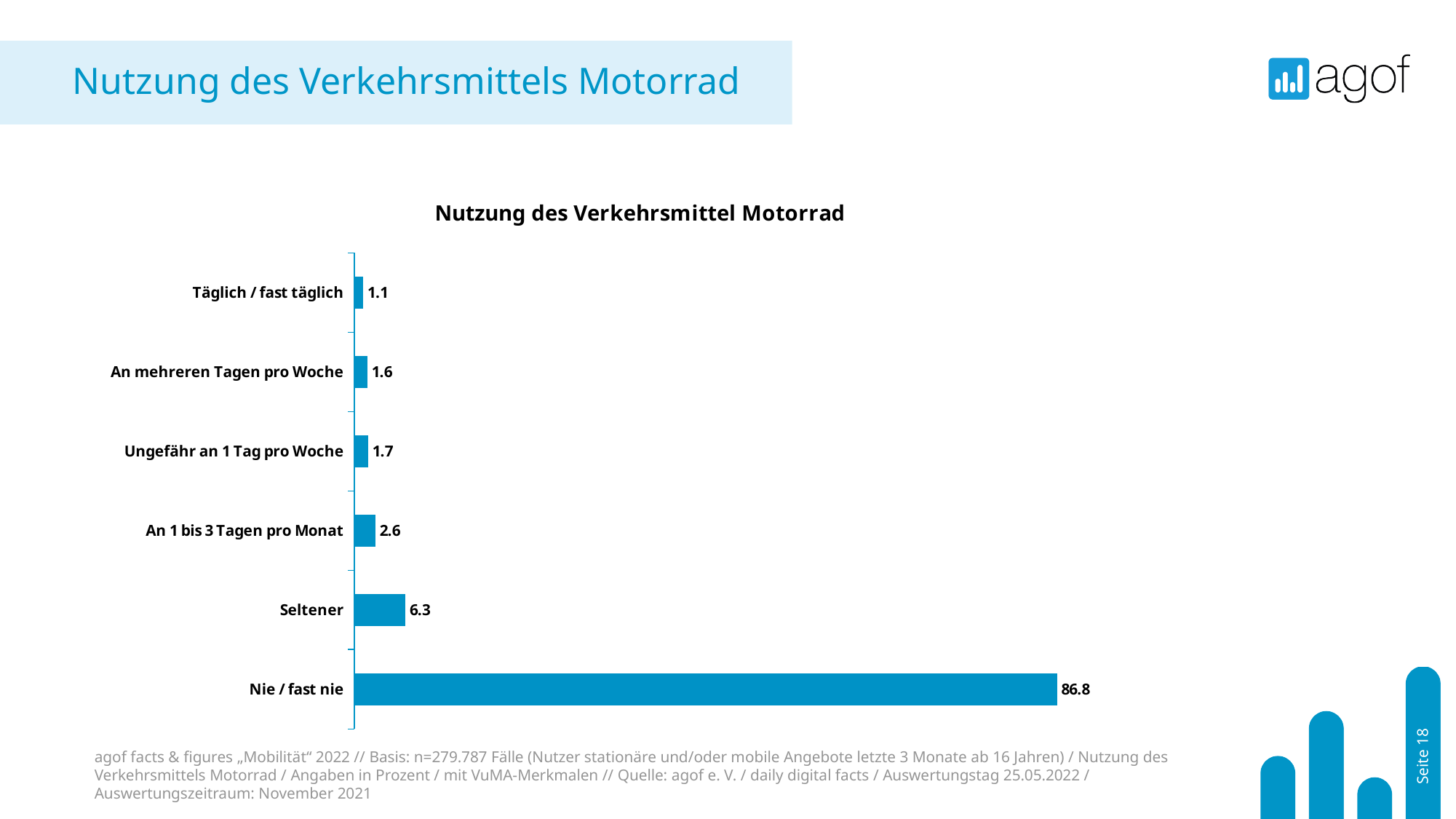
Which category has the lowest value? Täglich / fast täglich What is the value for "An 1 bis 3 Tagen pro Monat"? 2.6 What is the difference between the values for "Nie / fast nie" and "Seltener"? 80.5 What is the value for "Nie / fast nie"? 86.8 What is the title of the chart? Nutzung des Verkehrsmittel Motorrad What kind of chart is shown on the slide? Bar chart What is the value for "Ungefähr an 1 Tag pro Woche"? 1.7 Which is larger, the value for "An 1 bis 3 Tagen pro Monat" or the value for "An mehreren Tagen pro Woche"? An 1 bis 3 Tagen pro Monat What is the value for "Täglich / fast täglich"? 1.1 How many categories are shown in the chart? 6 Which category has the highest value? Nie / fast nie What is the value for "Seltener"? 6.3